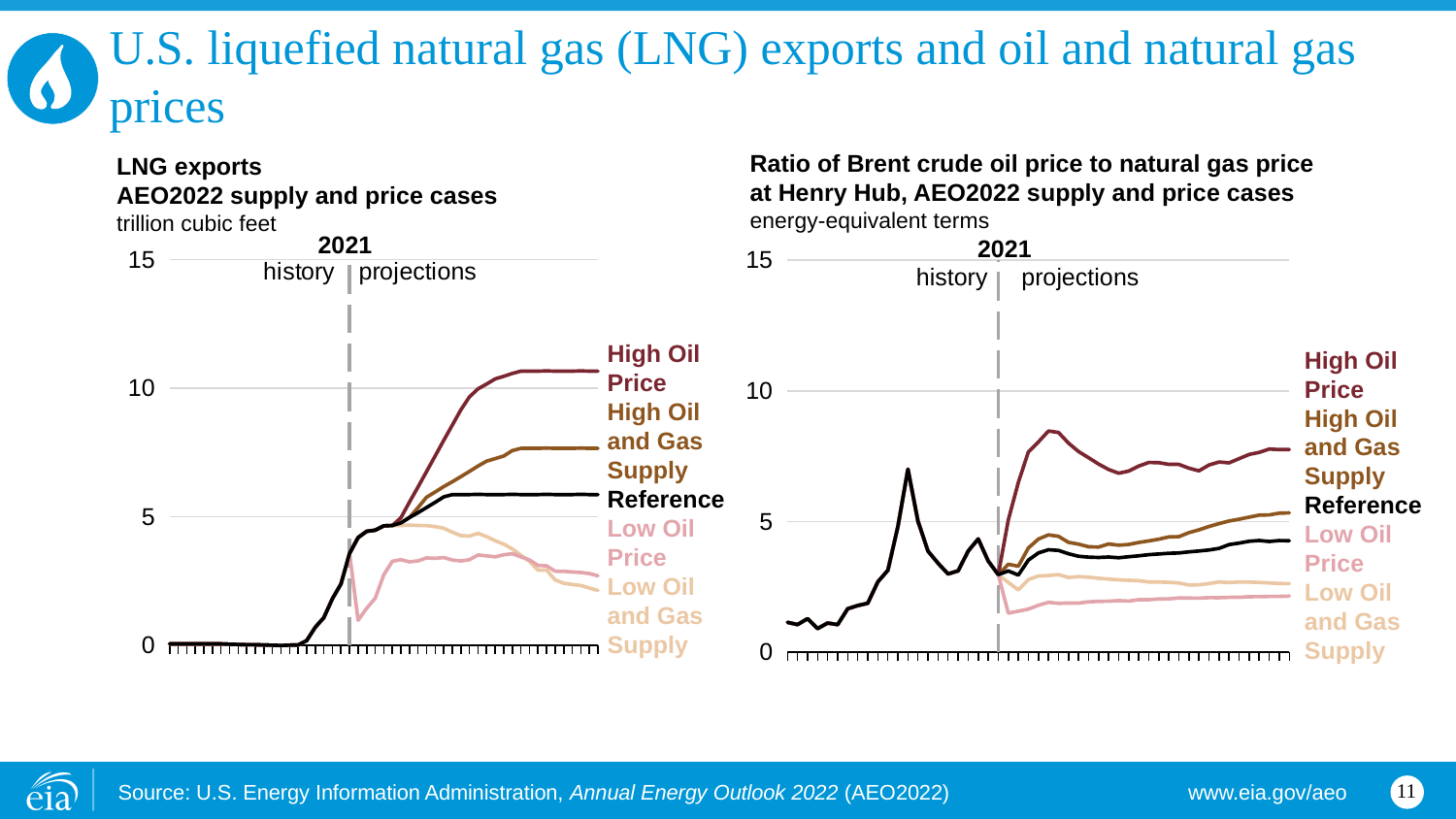
On the Ratio of Brent crude oil price to natural gas price chart, which series ends highest at the end of the projection period? High Oil Price What unit is shown for the LNG exports chart? trillion cubic feet On the Ratio of Brent crude oil price to natural gas price chart, is the final projected value for Reference greater or less than 5? less On the LNG exports chart, is the final projected value for Reference greater or less than 5? greater How many series are labelled on the LNG exports chart? 5 On the LNG exports chart, is the final projected value for High Oil Price greater or less than 10? greater On the LNG exports chart, which series ends highest at the end of the projection period? High Oil Price On the LNG exports chart, does the Reference series rise or fall over the projection period? rise On the LNG exports chart, which series ends lowest at the end of the projection period? Low Oil and Gas Supply How many series are labelled on the Ratio of Brent crude oil price to natural gas price chart? 5 What kind of chart is the LNG exports chart on the left? line chart